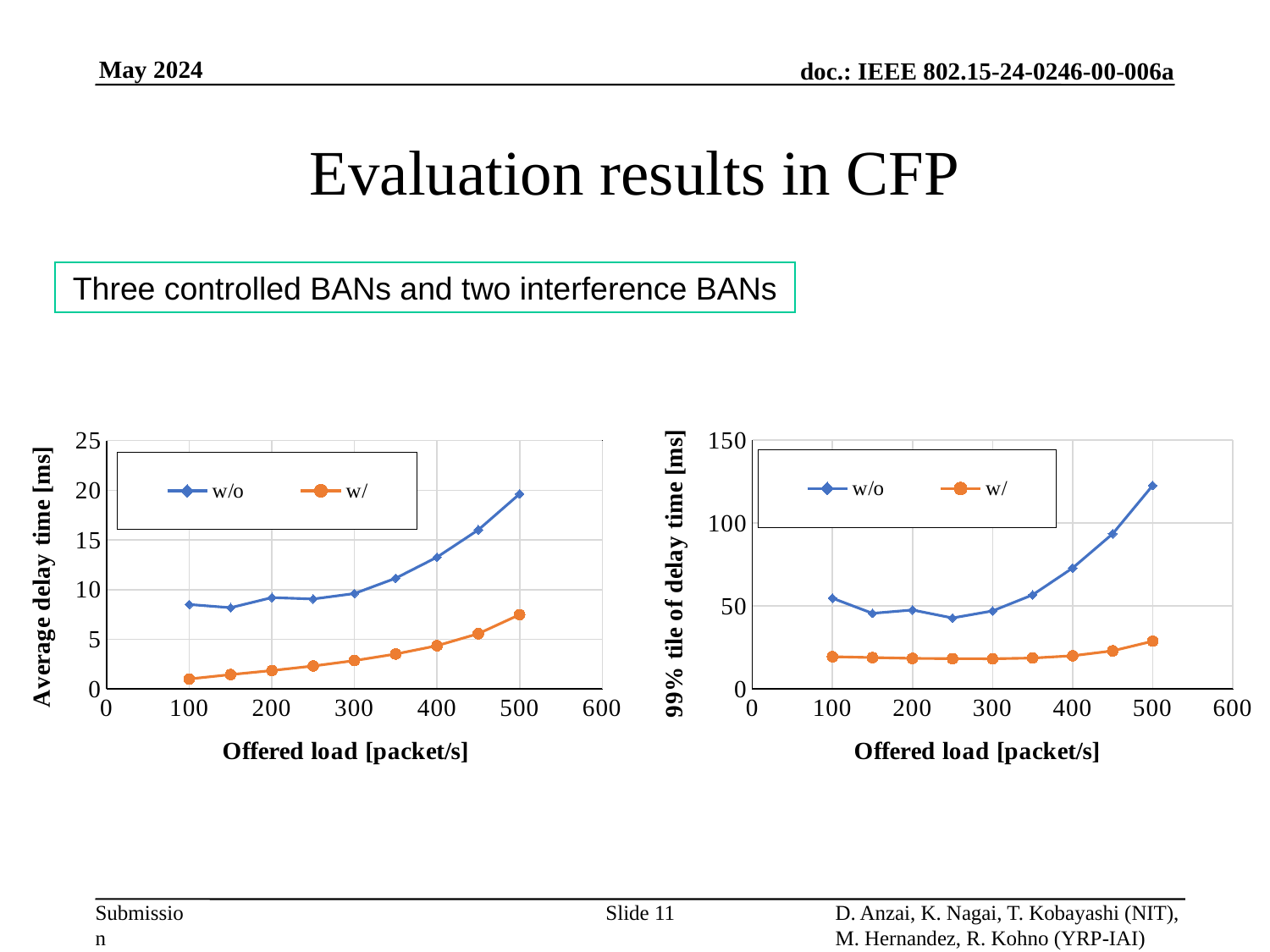
In the left chart (Average delay time), is the w/o value at an offered load of 100 packet/s greater or less than 10? less In the left chart (Average delay time), is the w/o value at an offered load of 500 packet/s greater or less than 15? greater What is the x-axis label of the right chart? Offered load [packet/s] In the left chart (Average delay time), is the w/ value at an offered load of 500 packet/s greater or less than 5? greater In the left chart (Average delay time), at which offered load does the w/o series reach its highest value? 500 In the right chart (99% tile of delay time), which series has the larger value at an offered load of 500 packet/s, w/o or w/? w/o What type of chart is the left chart (Average delay time)? line chart How many series does the legend of the right chart (99% tile of delay time) list? 2 In the left chart (Average delay time), how many data points are plotted for the w/ series? 9 In the left chart (Average delay time), do the w/ values rise or fall as the offered load increases? rise